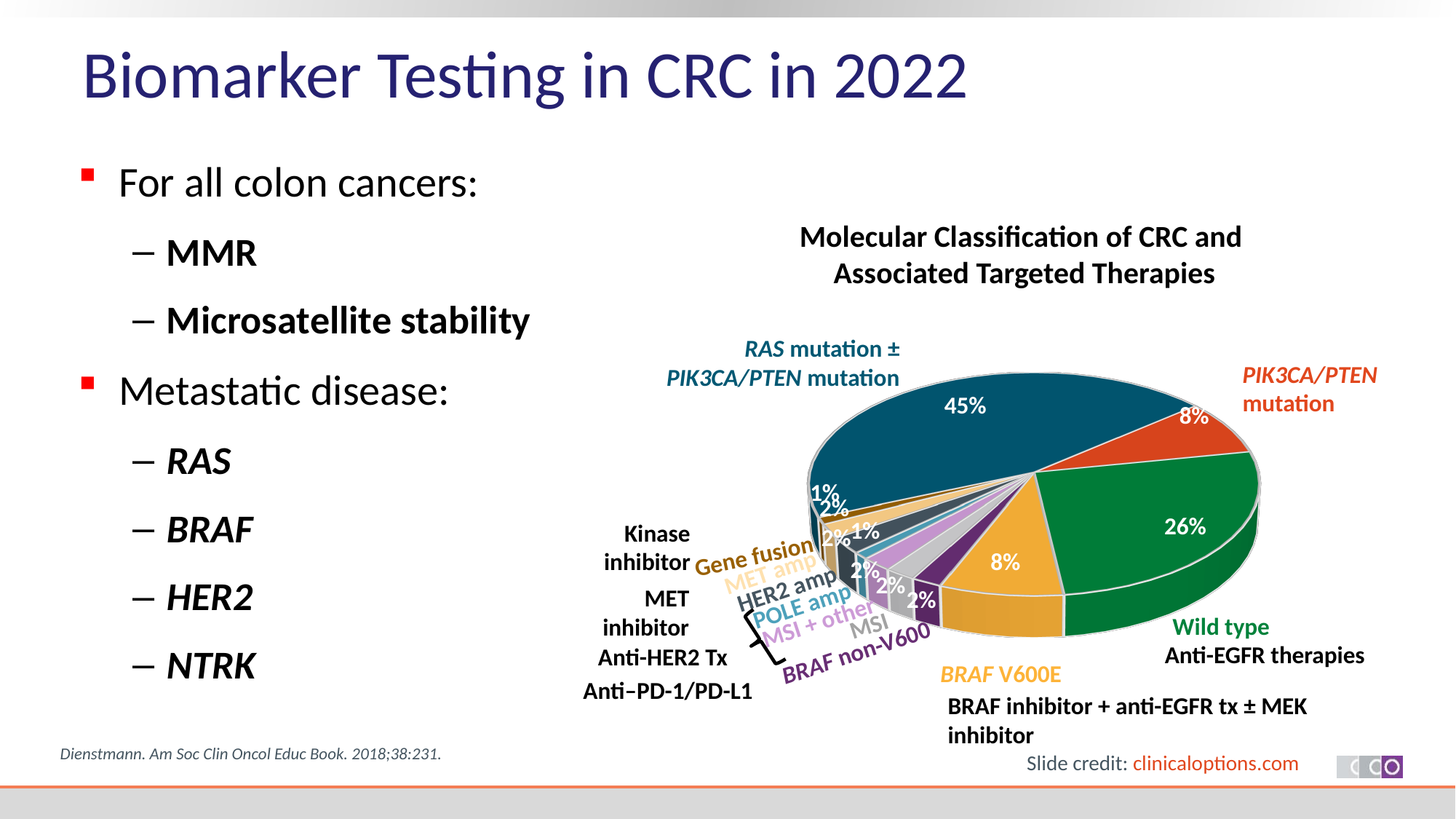
What percentage of the pie is the RAS mutation ± PIK3CA/PTEN mutation slice? 45% What is the difference in percentage points between the RAS mutation ± PIK3CA/PTEN mutation slice and the Wild type slice? 19 percentage points Which slice is larger, PIK3CA/PTEN mutation or RAS mutation ± PIK3CA/PTEN mutation? RAS mutation ± PIK3CA/PTEN mutation What percentage of the pie is the BRAF V600E slice? 8% How many labeled categories (slices) does the pie chart have? 11 What targeted therapy is listed for the Wild type slice? Anti-EGFR therapies What percentage of the pie is the Wild type slice? 26% What is the title of the pie chart? Molecular Classification of CRC and Associated Targeted Therapies Which slice is larger, Wild type or BRAF V600E? Wild type Which category has the largest slice of the pie? RAS mutation ± PIK3CA/PTEN mutation What percentage of the pie is the PIK3CA/PTEN mutation slice? 8% What kind of chart is shown on the slide? Pie chart